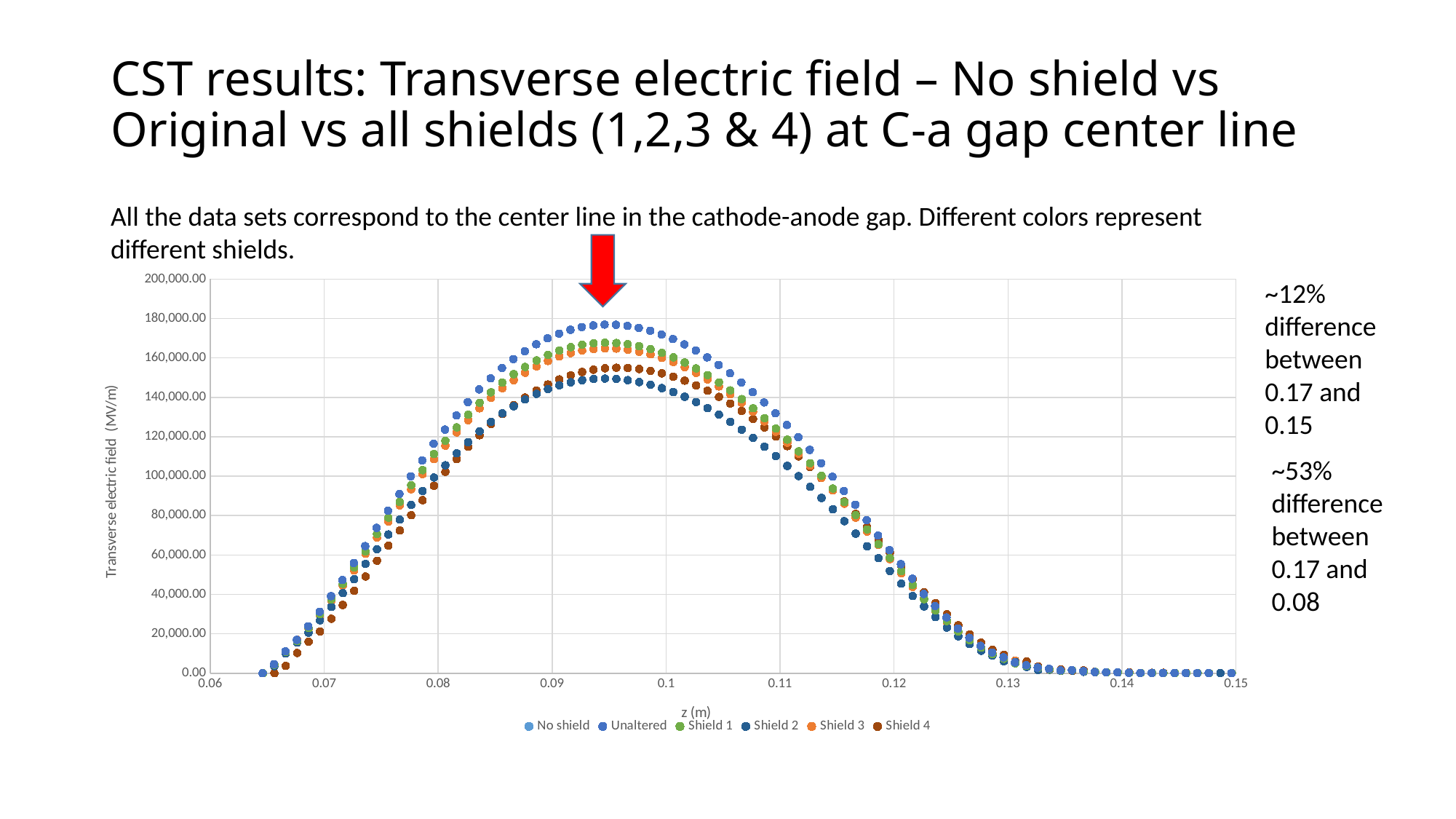
Is the peak value for Shield 4 greater or less than 140,000.00? greater Is the peak value for Shield 1 greater or less than 160,000.00? greater Do the values rise or fall along the x axis between z = 0.1 and z = 0.13? fall What kind of chart is shown on the slide? scatter chart How many series does the legend list? 6 Is the highest value plotted on the chart greater or less than 180,000.00? less Which series has the lowest peak value? Shield 2 Which series has the larger peak value, Shield 4 or Shield 2? Shield 4 What is the label of the x axis? z (m) Do the values rise or fall along the x axis between z = 0.07 and z = 0.09? rise Which series has the larger peak value, Shield 1 or Shield 2? Shield 1